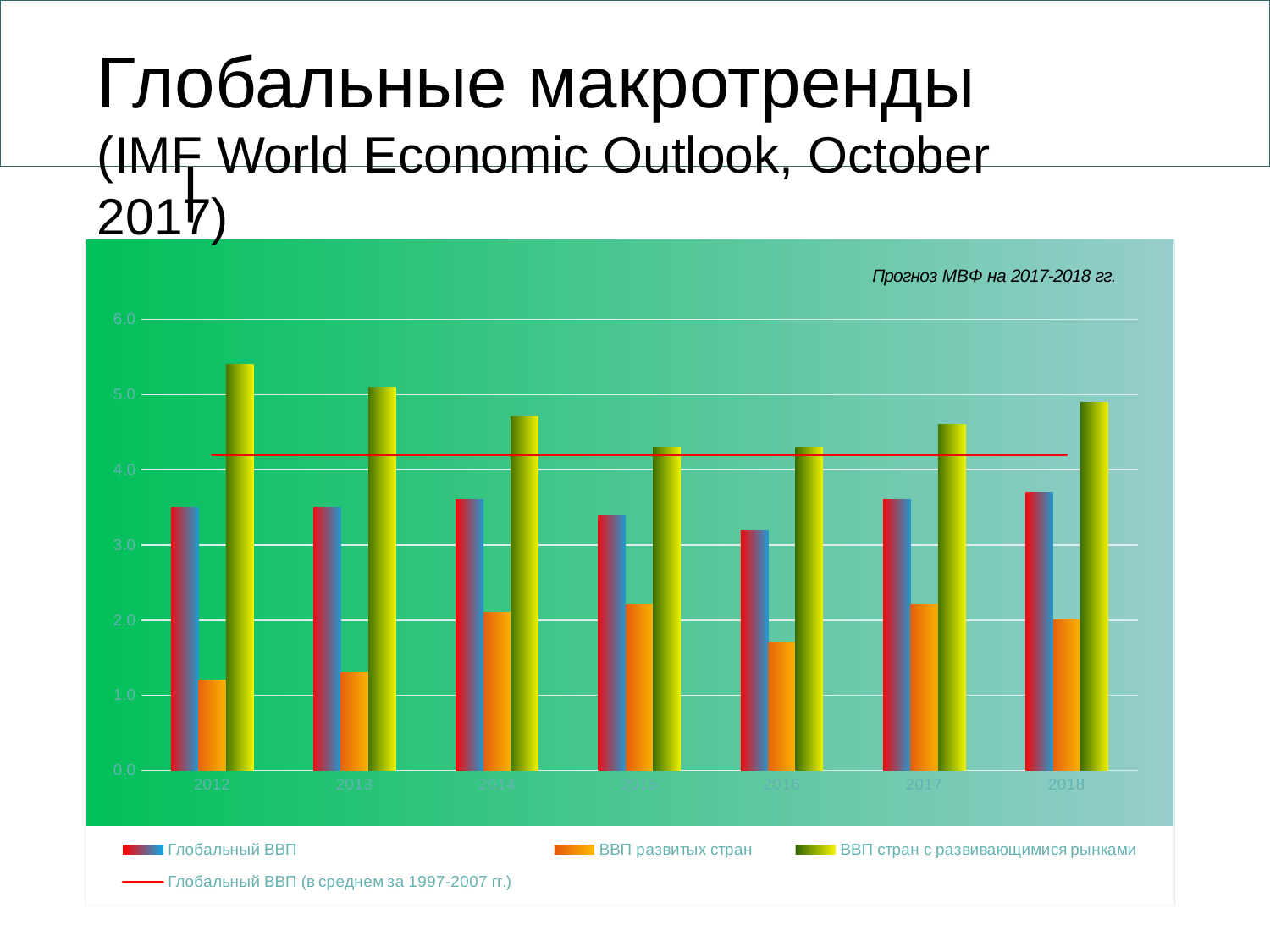
Is the value for 'ВВП развитых стран' in 2016 greater or less than 2.0? less What does the red horizontal line in the chart represent, according to the legend? Глобальный ВВП (в среднем за 1997-2007 гг.) Is the value for 'ВВП развитых стран' in 2012 greater or less than 2.0? less How many years are shown on the x axis of the chart? 7 How many entries does the chart legend list? 4 What kind of chart is shown on the slide? Bar chart (with a line) Do the bars for 'ВВП стран с развивающимися рынками' rise or fall from 2012 to 2015? fall Is the value for 'Глобальный ВВП' in 2016 greater or less than 3.0? greater In which year is the bar for 'Глобальный ВВП' the lowest? 2016 In 2012, which is larger: 'Глобальный ВВП' or 'ВВП стран с развивающимися рынками'? ВВП стран с развивающимися рынками In which year is the bar for 'ВВП стран с развивающимися рынками' the highest? 2012